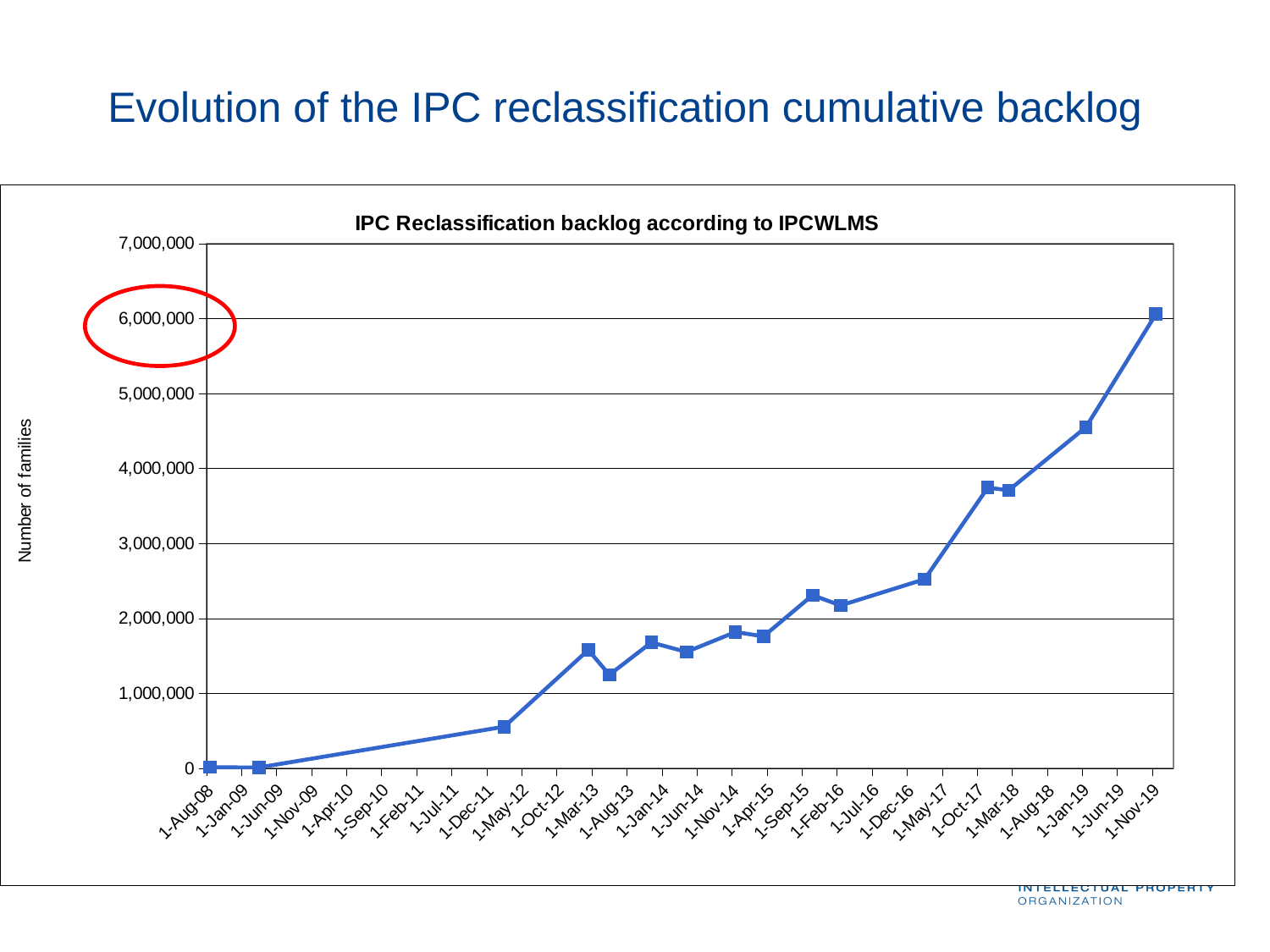
Is the value for 1-Dec-11 greater or less than 1,000,000? less Is the value for 1-Oct-17 greater or less than 4,000,000? less Overall, do the values rise or fall from 1-Aug-08 to 1-Nov-19? rise Is the value for 1-Dec-16 greater or less than 2,000,000? greater What is the label of the vertical axis? Number of families How many data points are plotted on the line? 16 What kind of chart is shown on the slide? line chart What is the title of the chart? IPC Reclassification backlog according to IPCWLMS Which is larger, the value for 1-Mar-13 or the value for 1-Aug-13? 1-Mar-13